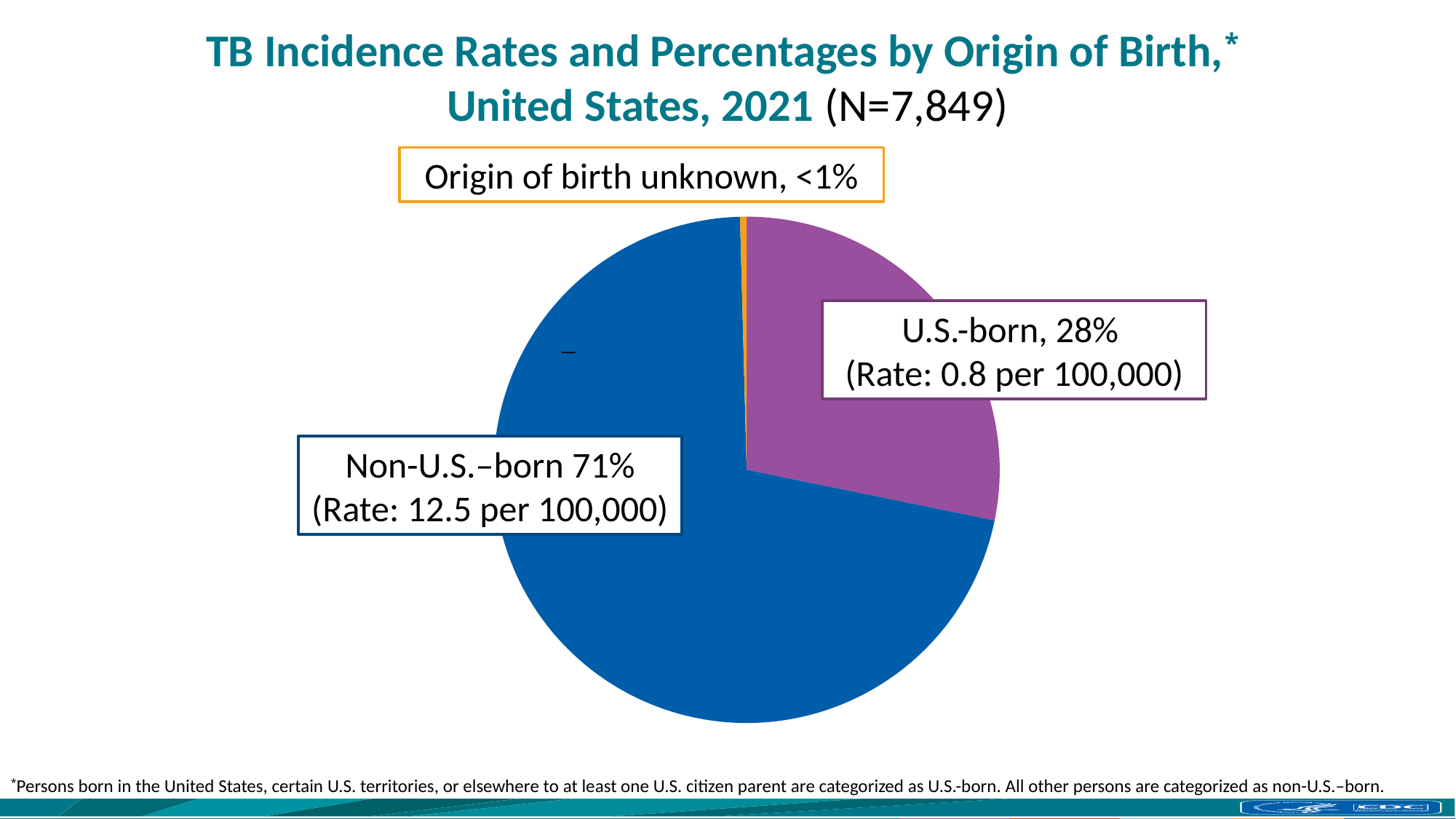
What percentage of TB cases is shown for Non-U.S.–born persons? 71% What percentage is shown for origin of birth unknown? <1% What percentage of TB cases is shown for U.S.-born persons? 28% Which is larger, the share for U.S.-born or the share for Non-U.S.–born? Non-U.S.–born What is the TB incidence rate shown for U.S.-born persons? 0.8 per 100,000 What is the total number of cases (N) given in the chart title? 7,849 Which category has the largest share of the pie? Non-U.S.–born Which category has the smallest share of the pie? Origin of birth unknown What is the difference in percentage points between the Non-U.S.–born and U.S.-born shares? 43 What is the TB incidence rate shown for Non-U.S.–born persons? 12.5 per 100,000 What kind of chart is shown on the slide? pie chart How many categories are shown in the pie chart? 3